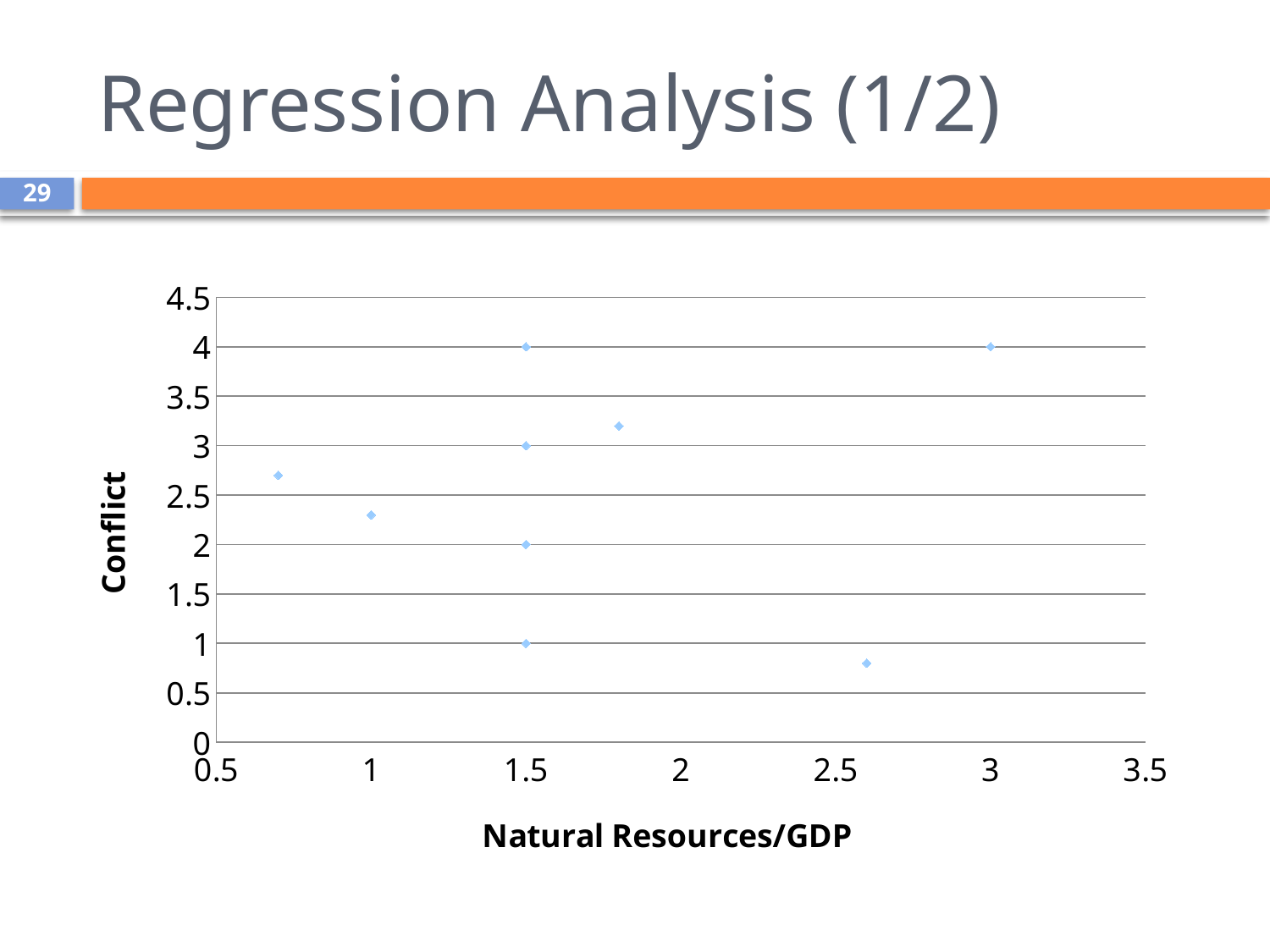
What Conflict value does the point at Natural Resources/GDP = 3 have? 4 What is the title of the horizontal axis? Natural Resources/GDP What kind of chart is shown on the slide? scatter chart What is the title of the vertical axis? Conflict How many data points are plotted on the chart? 9 What is the maximum value shown on the Conflict axis? 4.5 Is the Conflict value for the point at Natural Resources/GDP = 1 greater or less than 2? greater How many points are plotted at Natural Resources/GDP = 1.5? 4 What is the lowest Conflict value among the points plotted at Natural Resources/GDP = 1.5? 1 What is the highest Conflict value plotted on the chart? 4 Is the Conflict value for the point between Natural Resources/GDP 1.5 and 2 greater or less than 3? greater Is the lowest Conflict value on the chart greater or less than 1? less